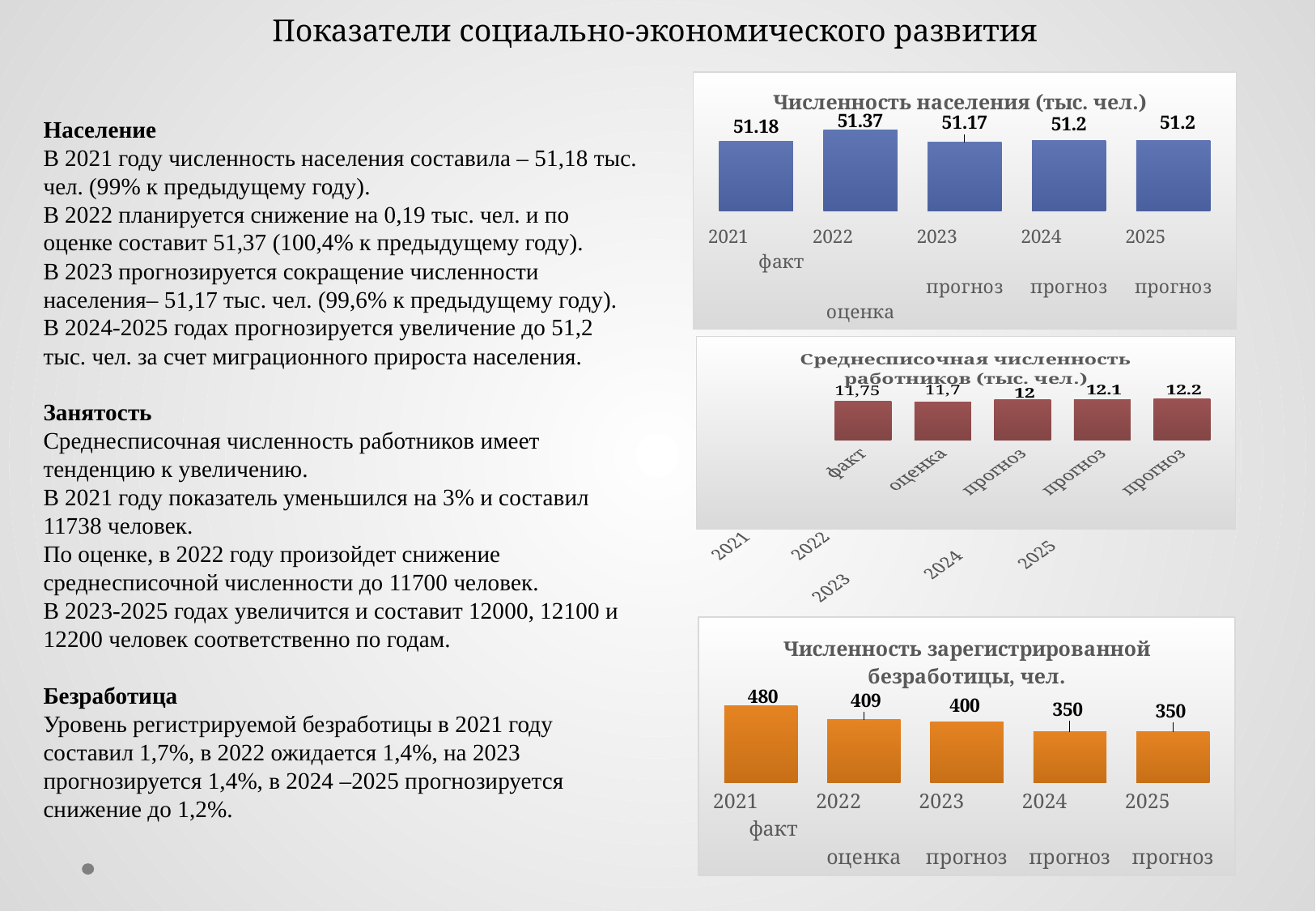
In the chart 'Численность населения (тыс. чел.)', what is the value for 2022? 51.37 In the chart 'Численность зарегистрированной безработицы, чел.', what is the difference between the 2021 and 2022 values? 71 In the chart 'Численность зарегистрированной безработицы, чел.', which year has the highest value? 2021 In the chart 'Среднесписочная численность работников (тыс. чел.)', what is the value for 2025? 12.2 In the chart 'Среднесписочная численность работников (тыс. чел.)', do the values rise or fall from 2023 to 2025? rise In the chart 'Численность зарегистрированной безработицы, чел.', what is the value for 2021? 480 In the chart 'Численность населения (тыс. чел.)', how many bars are plotted? 5 What colour are the bars in the chart 'Среднесписочная численность работников (тыс. чел.)'? dark red What type of chart is 'Численность зарегистрированной безработицы, чел.'? bar chart In the chart 'Численность населения (тыс. чел.)', which year has the lowest value? 2023 In the chart 'Численность зарегистрированной безработицы, чел.', which is larger, the value for 2022 or the value for 2024? 2022 In the chart 'Среднесписочная численность работников (тыс. чел.)', what is the value for 2021? 11,75